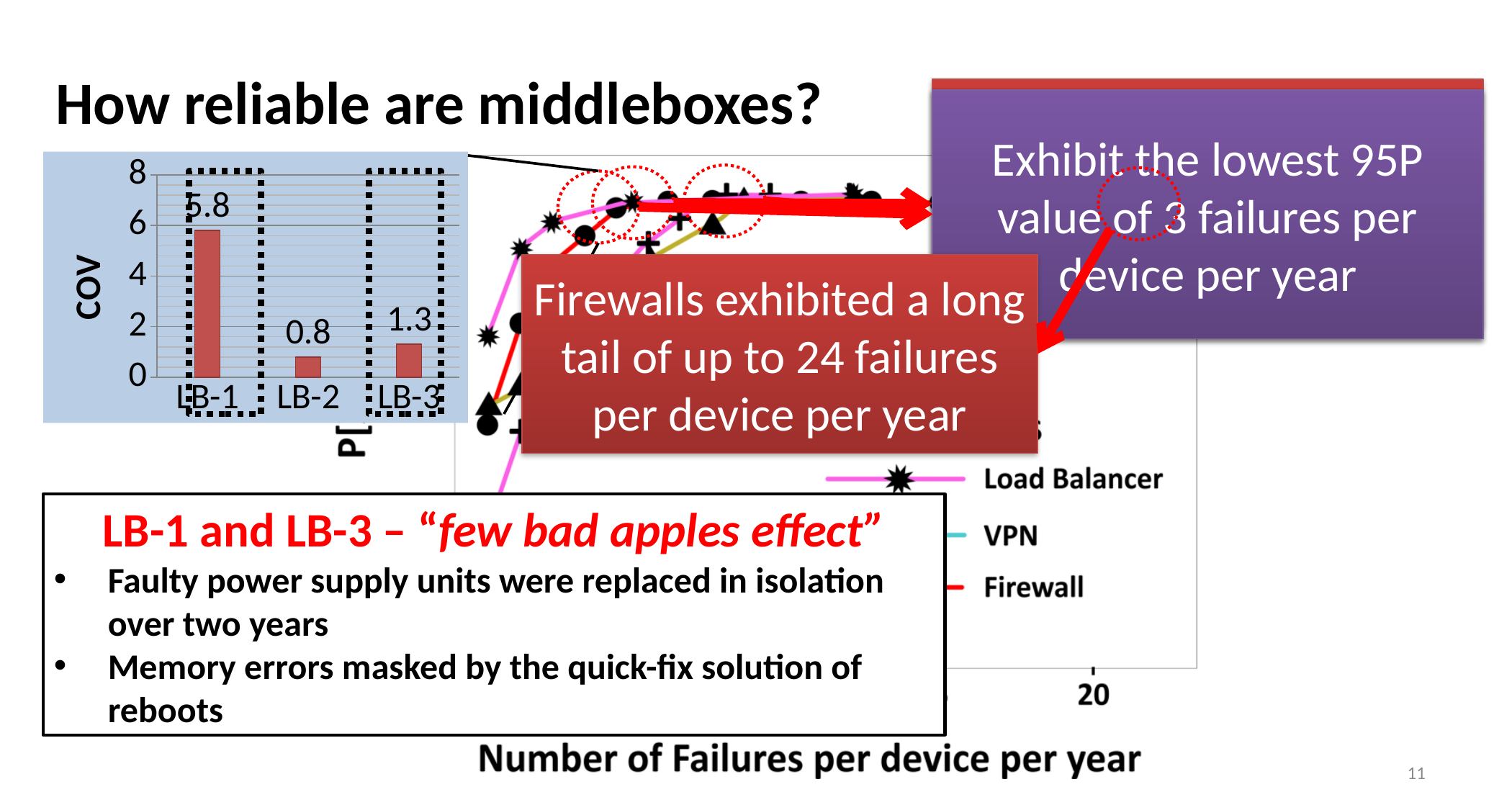
How many categories are shown in the bar chart on the left? 3 In the bar chart on the left, what is the COV value for LB-1? 5.8 In the bar chart on the left, is the COV value for LB-1 greater or less than 4? greater In the bar chart on the left, what is the difference between the COV of LB-1 and LB-2? 5.0 In the bar chart on the left, what is the COV value for LB-2? 0.8 In the bar chart on the left, which category has the lowest COV? LB-2 In the bar chart on the left, what is the COV value for LB-3? 1.3 In the bar chart on the left, which has a larger COV, LB-2 or LB-3? LB-3 In the bar chart on the left, which category has the highest COV? LB-1 What kind of chart is the COV chart on the left of the slide? bar chart In the bar chart on the left, what is the difference between the COV of LB-3 and LB-2? 0.5